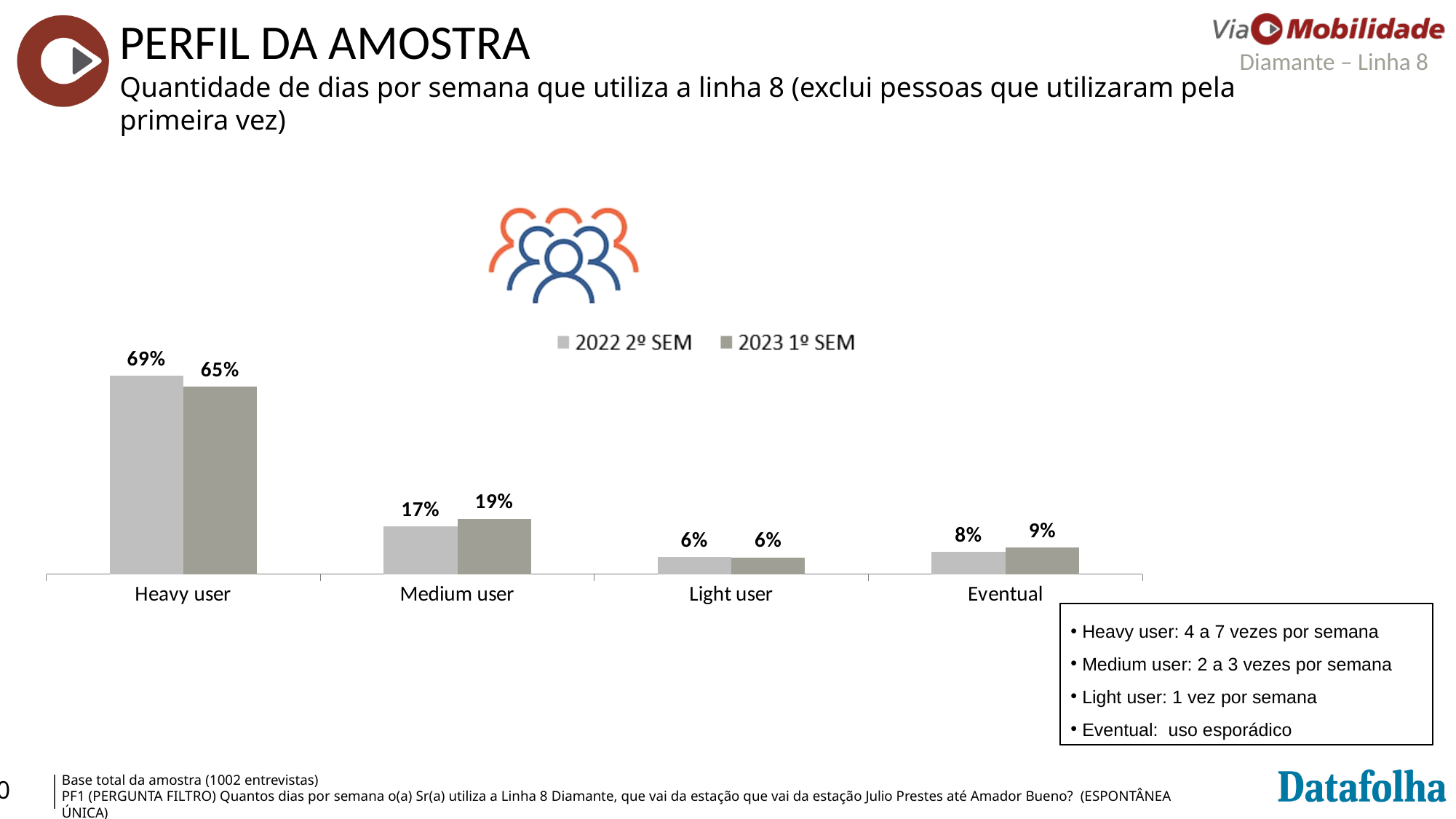
What kind of chart is shown on the slide? Bar chart Which is larger for Medium user: the 2022 2º SEM value or the 2023 1º SEM value? 2023 1º SEM What is the value for Eventual in the 2022 2º SEM series? 8% How many categories are shown on the x axis? 4 What is the value for Medium user in the 2023 1º SEM series? 19% What is the value for Light user in the 2023 1º SEM series? 6% What is the value for Heavy user in the 2022 2º SEM series? 69% How many series does the legend list? 2 Which category has the lowest value in the 2022 2º SEM series? Light user What are the two series named in the legend? 2022 2º SEM and 2023 1º SEM What is the difference between the 2022 2º SEM and 2023 1º SEM values for Heavy user? 4% Which category has the highest value in the 2023 1º SEM series? Heavy user